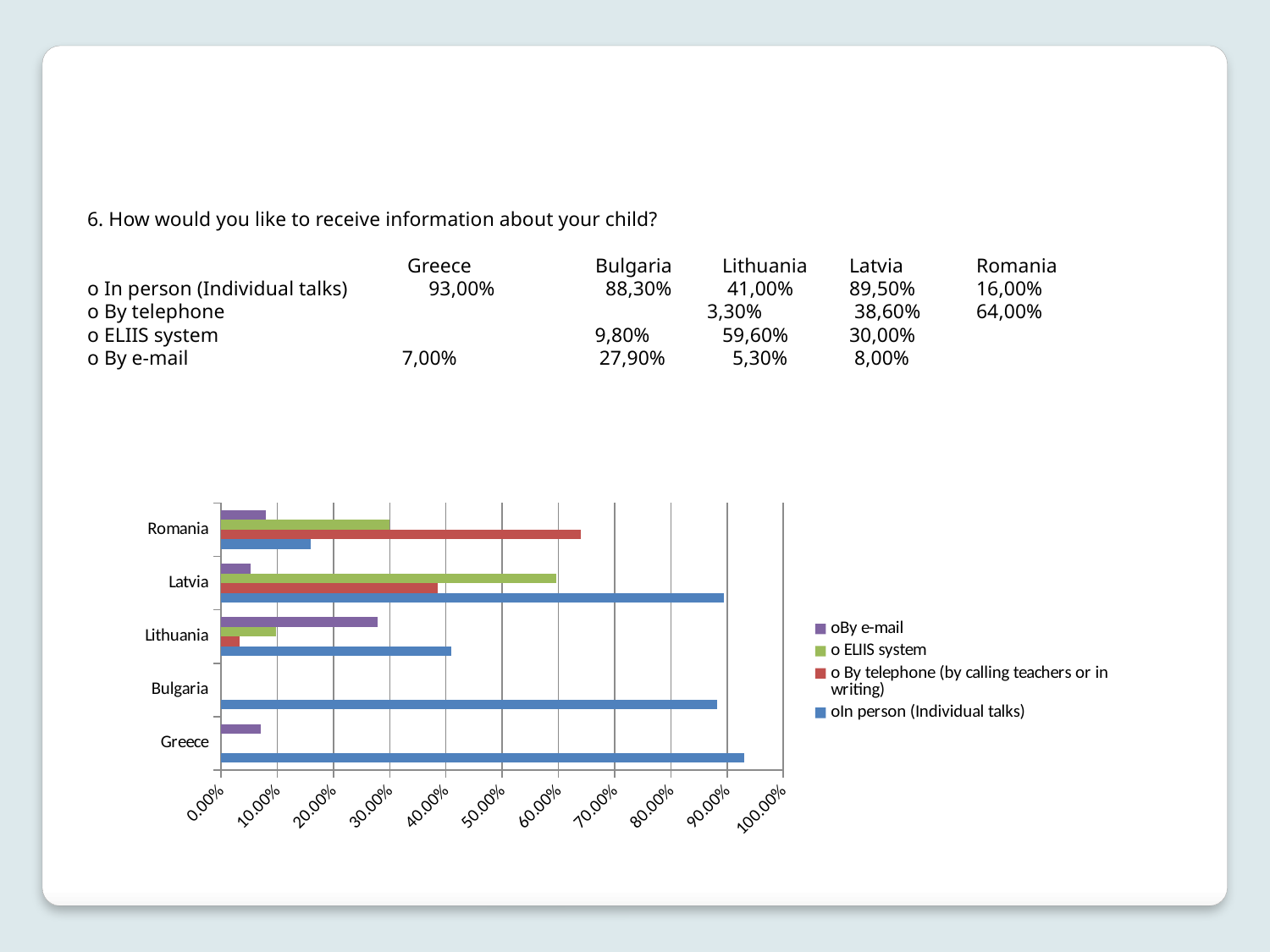
Which country has the lowest value for 'In person (Individual talks)'? Romania Which country has the highest value for 'By e-mail'? Lithuania Is the 'In person (Individual talks)' value for Greece greater or less than 80.00%? greater Which country has the highest value for 'ELIIS system'? Latvia Is the 'In person (Individual talks)' value for Lithuania greater or less than 50.00%? less How many countries are shown on the chart's vertical axis? 5 Which is larger for Romania: the 'By telephone' value or the 'ELIIS system' value? By telephone What value does the slide give for 'In person (Individual talks)' in Greece? 93,00% What kind of chart is shown on the slide? bar chart Which colour represents 'In person (Individual talks)' in the chart? blue How many series does the chart legend list? 4 Which country has the highest value for 'By telephone'? Romania